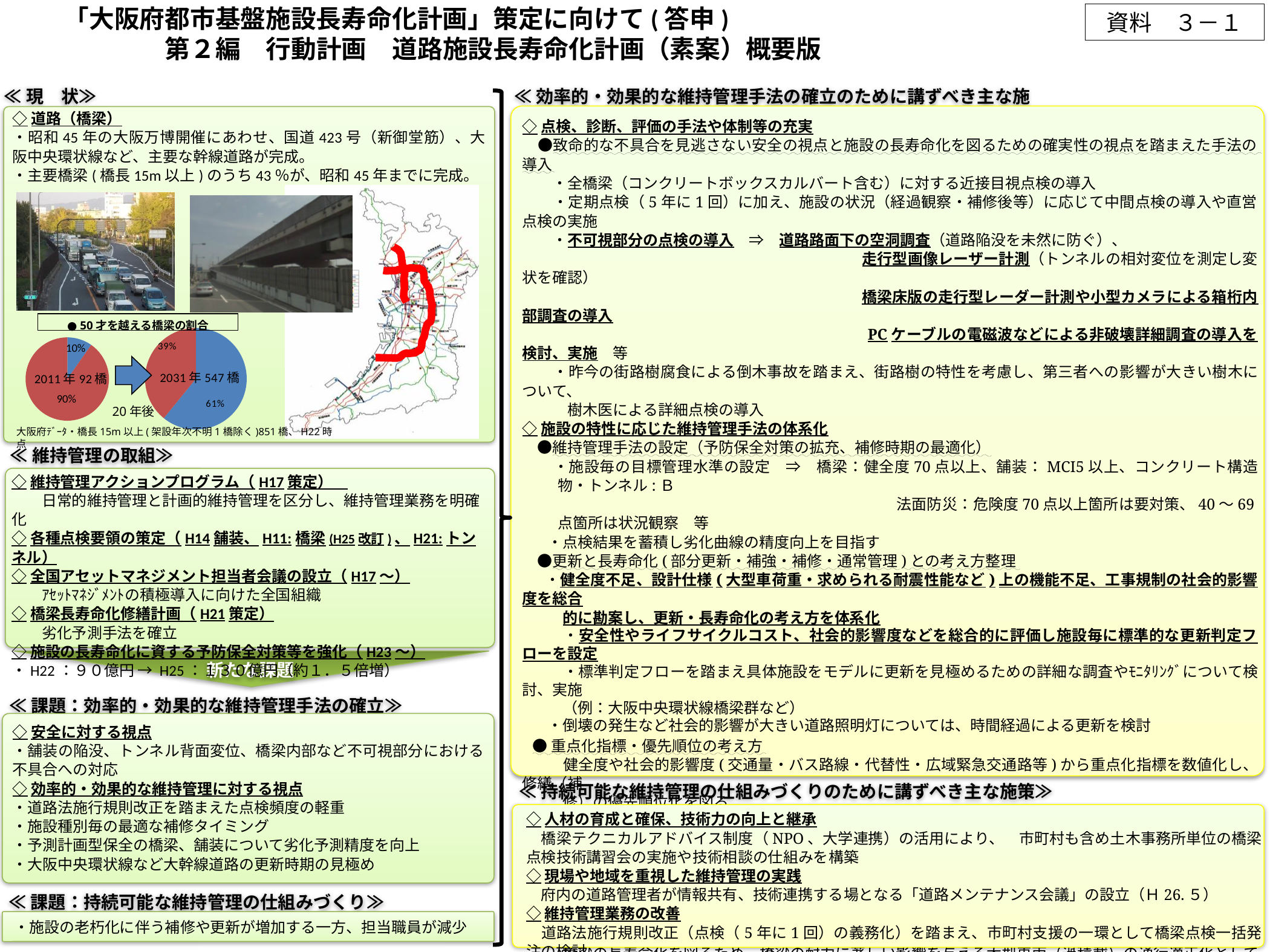
In the right pie chart (2031年 547橋), what percentage is shown for the red slice? 39% In the right pie chart (2031年 547橋), what percentage is shown for the blue slice? 61% What number of bridges is written in the centre of the right pie chart? 547橋 In the right pie chart (2031年), which slice is larger, the blue one or the red one? The blue one (61%) In the left pie chart (2011年 92橋), what percentage is shown for the red slice? 90% In the left pie chart (2011年 92橋), what percentage is shown for the blue slice? 10% In the left pie chart (2011年), what is the difference in percentage points between the red slice and the blue slice? 80 percentage points What is the title written above the two pie charts? ●50才を越える橋梁の割合 What kind of charts are shown under the heading ●50才を越える橋梁の割合? Pie charts What text is written beneath the arrow between the two pie charts? 20年後 What number of bridges is written in the centre of the left pie chart? 92橋 How many pie charts are shown on the slide? 2